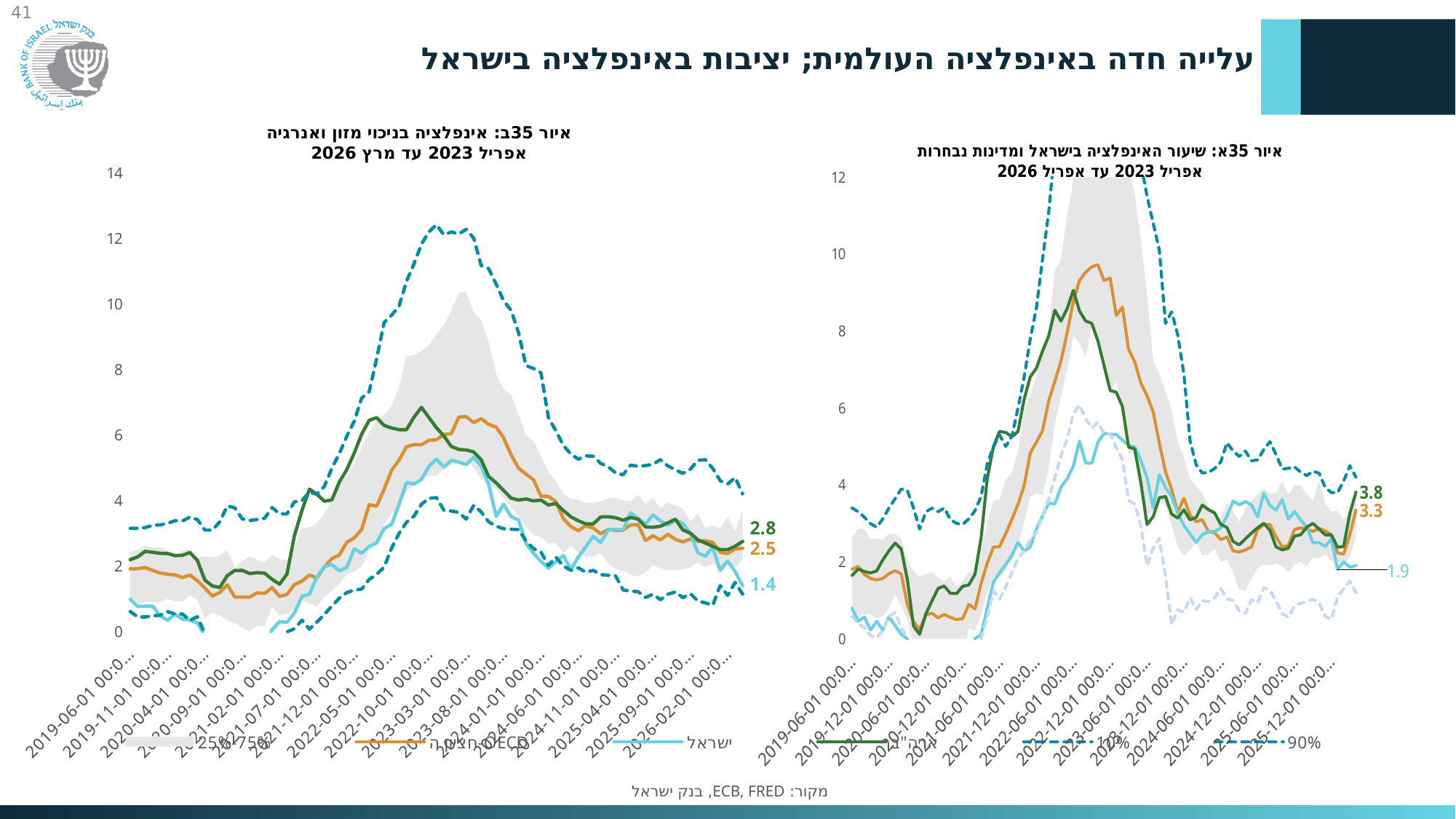
In the left chart (איור 35ב), what is the final value labelled on the orange line? 2.5 In the left chart (איור 35ב), what is the final value labelled on the light blue line? 1.4 In the right chart (איור 35א), what is the final value labelled on the light blue line? 1.9 In the right chart (איור 35א), is the peak value of the orange line greater or less than 8? greater In the right chart (איור 35א), what is the final value labelled on the green line? 3.8 In the left chart (איור 35ב), which line has the lowest final labelled value? the light blue line (1.4) In the left chart (איור 35ב), what is the difference between the final labelled values of the green line and the light blue line? 1.4 In the right chart (איור 35א), what is the final value labelled on the orange line? 3.3 In the right chart (איור 35א), is the final labelled value of the orange line larger or smaller than that of the light blue line? larger What kind of chart is the left chart (איור 35ב)? line chart In the right chart (איור 35א), what is the difference between the final labelled values of the green line and the orange line? 0.5 In the left chart (איור 35ב), what is the final value labelled on the green line? 2.8